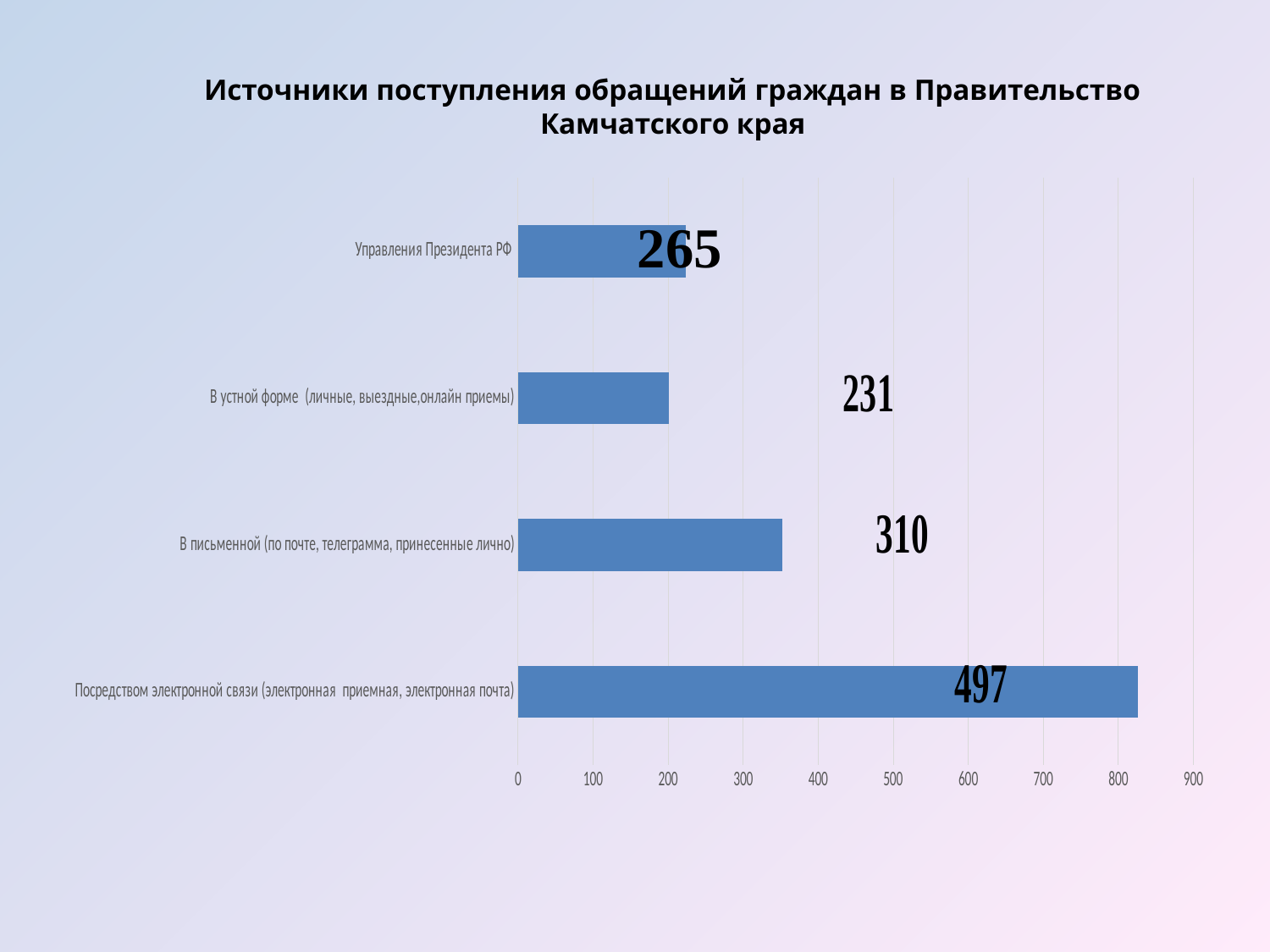
Which source of appeals has the longest bar? Посредством электронной связи (электронная приемная, электронная почта) Which bar is longer: 'В письменной (по почте, телеграмма, принесенные лично)' or 'Управления Президента РФ'? В письменной (по почте, телеграмма, принесенные лично) What kind of chart is shown on the slide? bar chart Is the bar for 'В устной форме (личные, выездные, онлайн приемы)' greater or less than 300? less Is the bar for 'Управления Президента РФ' greater or less than 300? less Is the bar for 'В письменной (по почте, телеграмма, принесенные лично)' greater or less than 300? greater How many categories (sources of appeals) does the chart show? 4 Which bar is longer: 'Посредством электронной связи' or 'В письменной'? Посредством электронной связи What is the title of the chart? Источники поступления обращений граждан в Правительство Камчатского края What is the maximum value shown on the horizontal axis? 900 Which source of appeals has the shortest bar? В устной форме (личные, выездные, онлайн приемы)